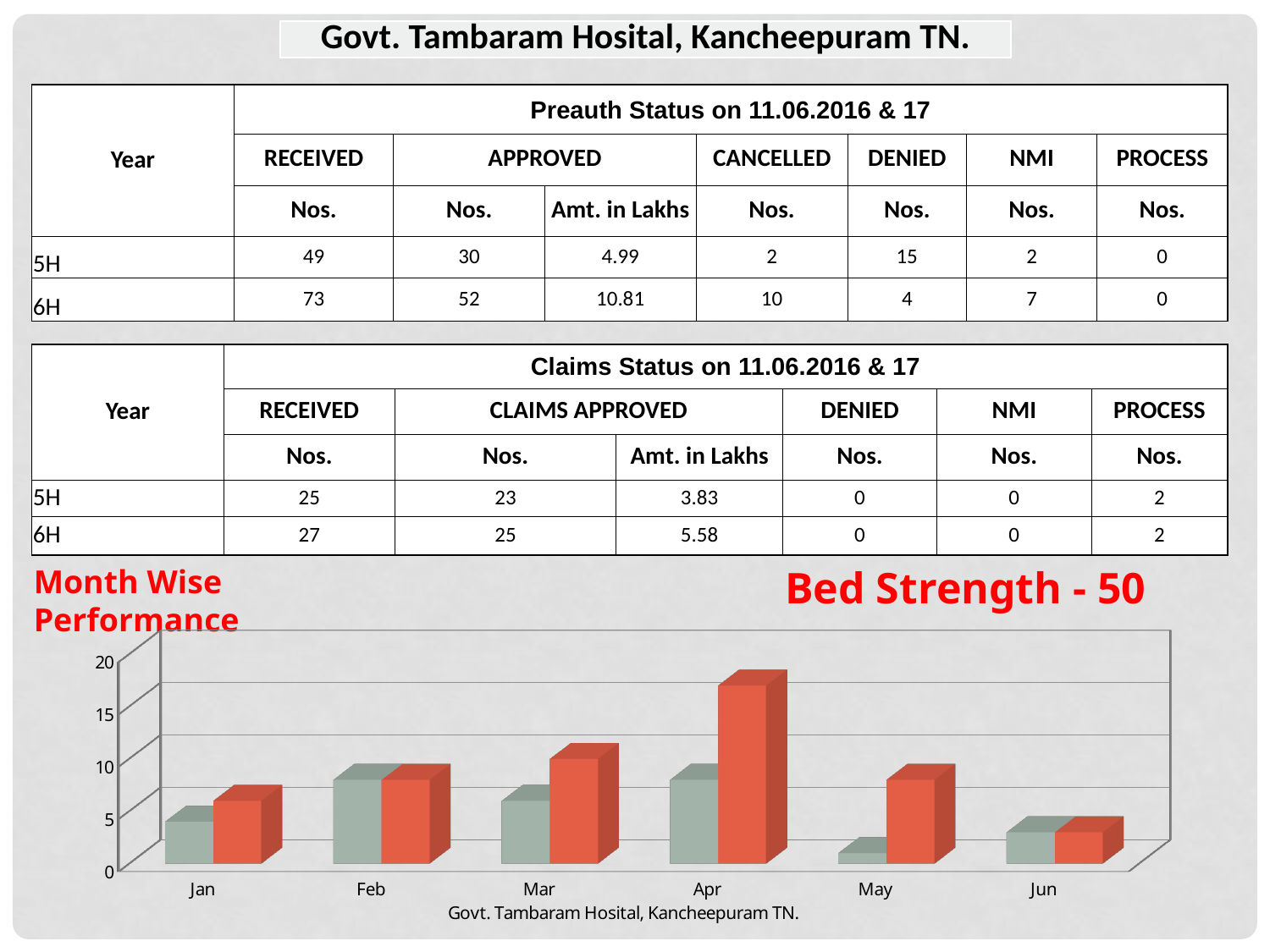
Which month has the taller red bar, May or Jun? May How many months are shown on the x axis of the bar chart? 6 What text appears below the x axis of the bar chart? Govt. Tambaram Hosital, Kancheepuram TN. Is the value of the red bar for Apr greater or less than 15? greater Is the value of the grey bar for May greater or less than 5? less In which month is the red bar the tallest? Apr In which month is the grey bar the shortest? May For Apr, which bar is taller, the grey bar or the red bar? the red bar How many bar series (colours) are plotted in the chart? 2 What kind of chart is shown at the bottom of the slide? bar chart Is the value of the red bar for Mar greater or less than 5? greater